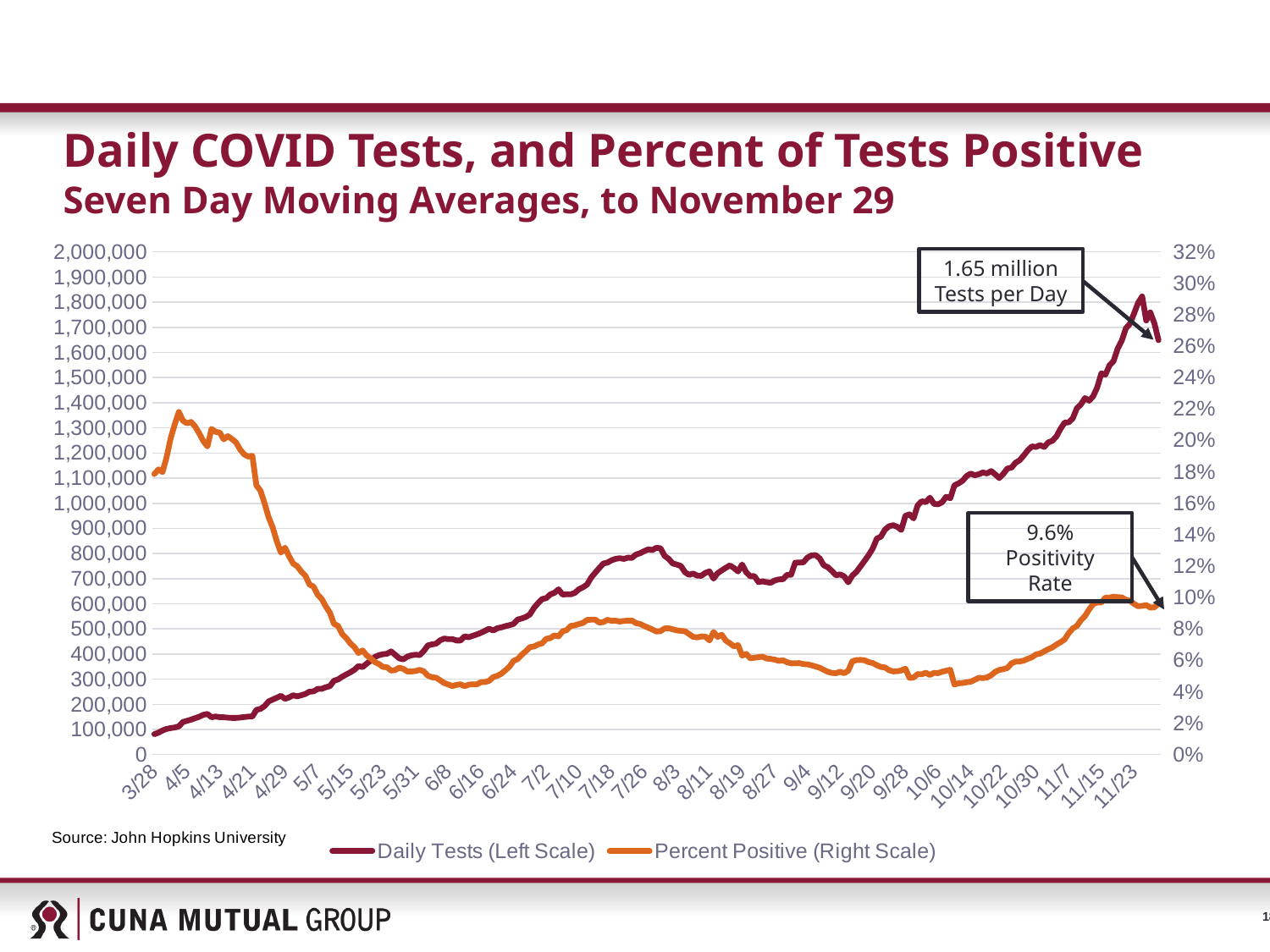
Is the Daily Tests value on 3/28 greater or less than 200,000? less According to the annotation, what is the positivity rate at the end of the series? 9.6% What are the two series named in the legend? Daily Tests (Left Scale) and Percent Positive (Right Scale) Is the Percent Positive value around 10/14 greater or less than 6%? less What is the source cited for the chart? John Hopkins University What kind of chart is shown on the slide? Line chart Does the Percent Positive series rise or fall from 4/5 to 6/8? Fall According to the annotation, what is the number of daily tests at the end of the series? 1.65 million Tests per Day Does the Daily Tests series overall rise or fall from 3/28 to 11/23? Rise Is the Daily Tests value around 9/12 greater or less than 800,000? less How many series does the legend list? 2